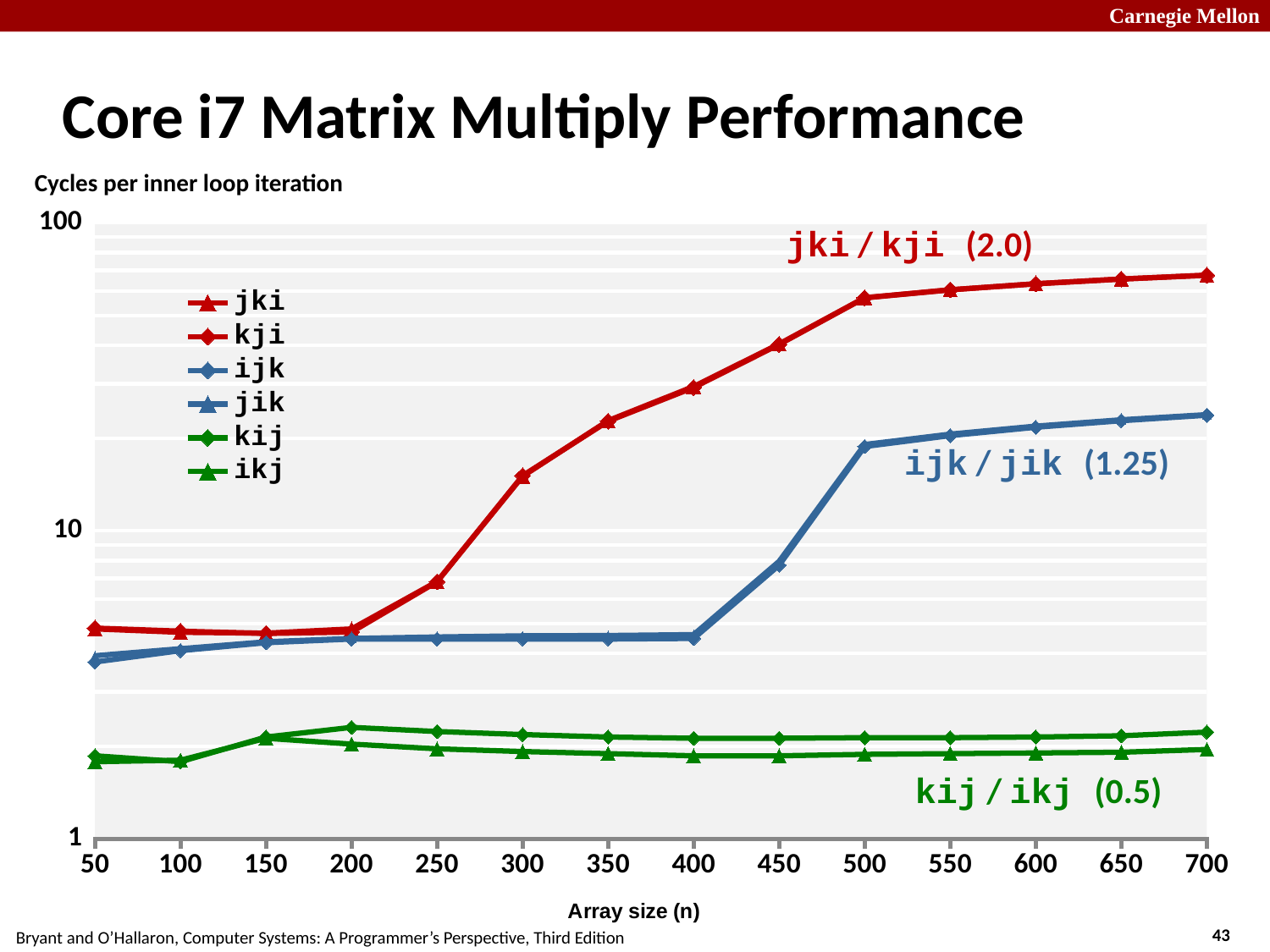
Is the value for jki at array size 700 greater or less than 10? greater Is the value for kij at array size 700 greater or less than 10? less Which has the higher value at array size 700, jki or kij? jki Is the value for ijk at array size 500 greater or less than 10? greater How many array size values are plotted along the x axis? 14 Which has the higher value at array size 300, jki or ijk? jki What is the x-axis title of the chart? Array size (n) What kind of chart is shown on the slide? line chart Does the jki series rise or fall as the array size increases from 50 to 700? rise How many series does the legend list? 6 What label is given for the y axis of the chart? Cycles per inner loop iteration